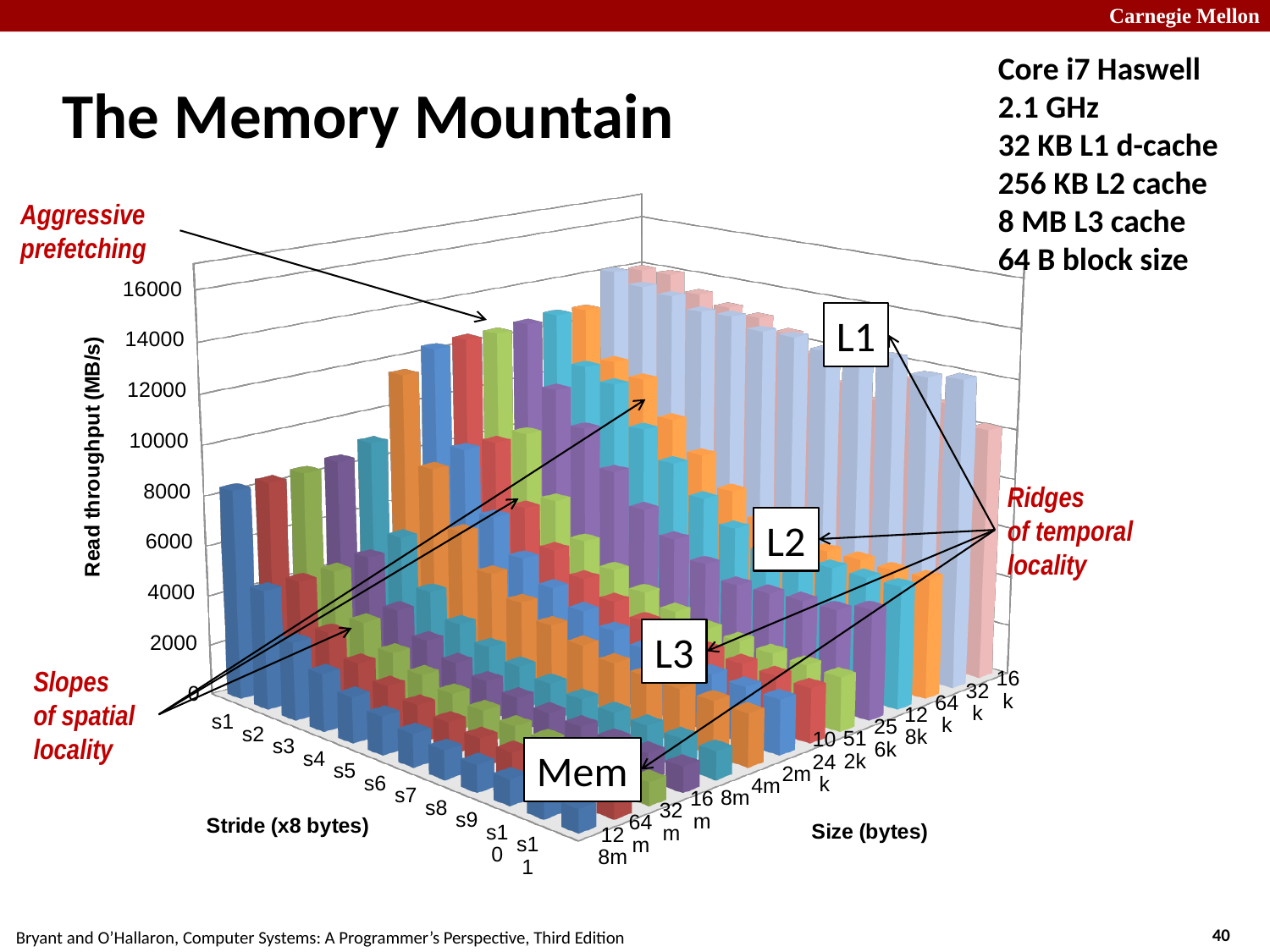
Which stride has the higher read throughput at size 128m, s1 or s11? s1 What is the label on the vertical axis of the chart? Read throughput (MB/s) How many stride categories (s1 through s11) are shown along the stride axis? 11 For size 128m, does read throughput rise or fall as the stride increases from s1 to s11? fall What is the highest tick value shown on the read throughput axis? 16000 Which memory level label on the chart is placed at the lowest region of the mountain? Mem Is the read throughput for stride s11 at size 128m greater or less than 4000? less What kind of chart is shown on the slide? bar chart Is the read throughput for stride s1 at size 128m greater or less than 4000? greater Is the read throughput for stride s1 at size 128m greater or less than 12000? less Which size has the higher read throughput at stride s1, 16k or 128m? 16k What is the title of the chart on the slide? The Memory Mountain